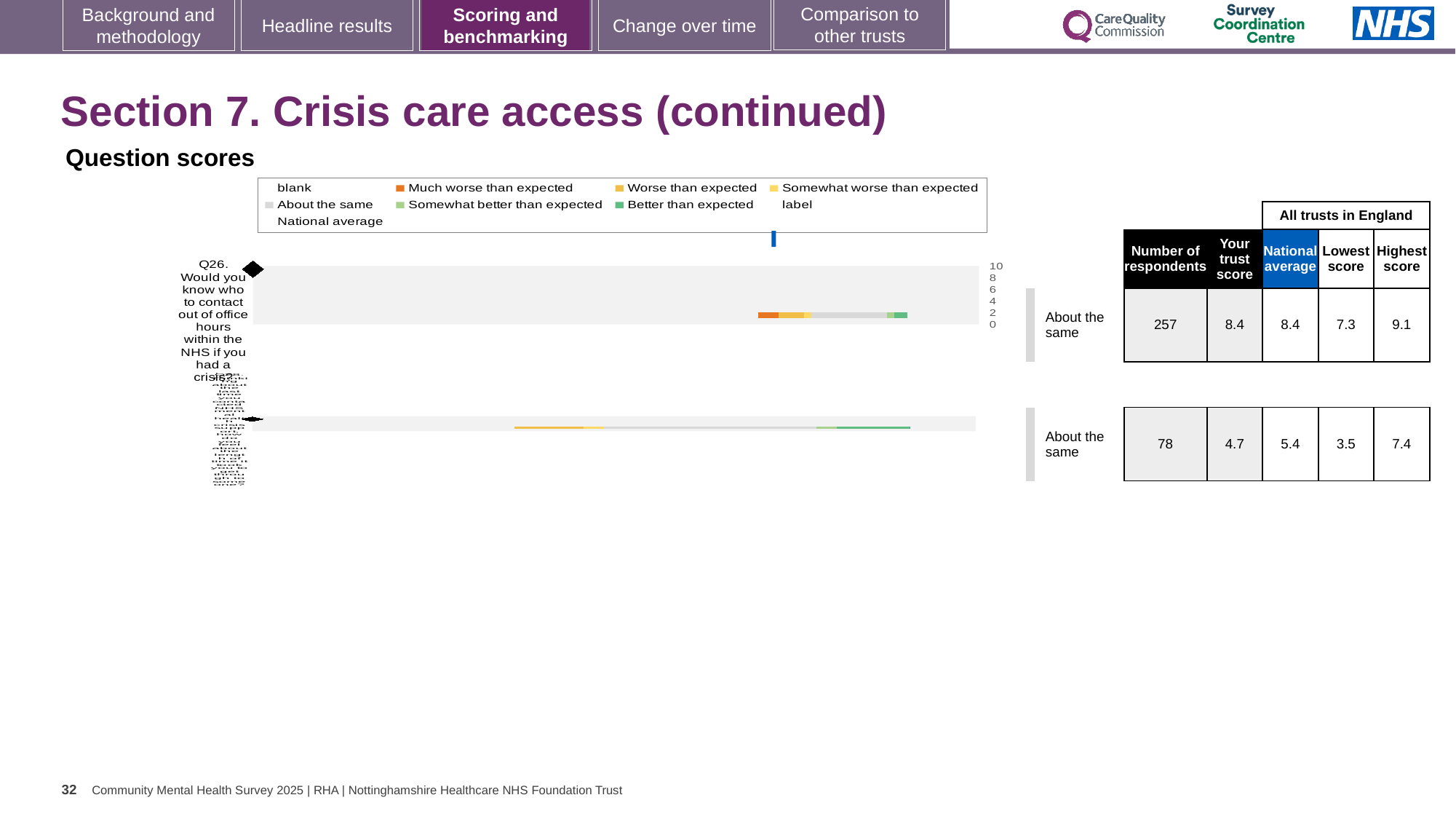
What benchmark category is Q26 placed in? About the same What is the national average for Q26? 8.4 What is the lowest score among all trusts in England for Q26? 7.3 What is the highest score among all trusts in England for Q26? 9.1 What is your trust score for Q26? 8.4 What is the difference between the highest and lowest scores for Q26? 1.8 How many question rows are plotted in the question scores chart? 2 What kind of chart is used to show the question scores on this slide? bar chart In the chart legend, what colour represents 'Better than expected'? green In the chart legend, what colour represents 'Much worse than expected'? orange What is the number of respondents for Q26 (Would you know who to contact out of office hours within the NHS if you had a crisis?)? 257